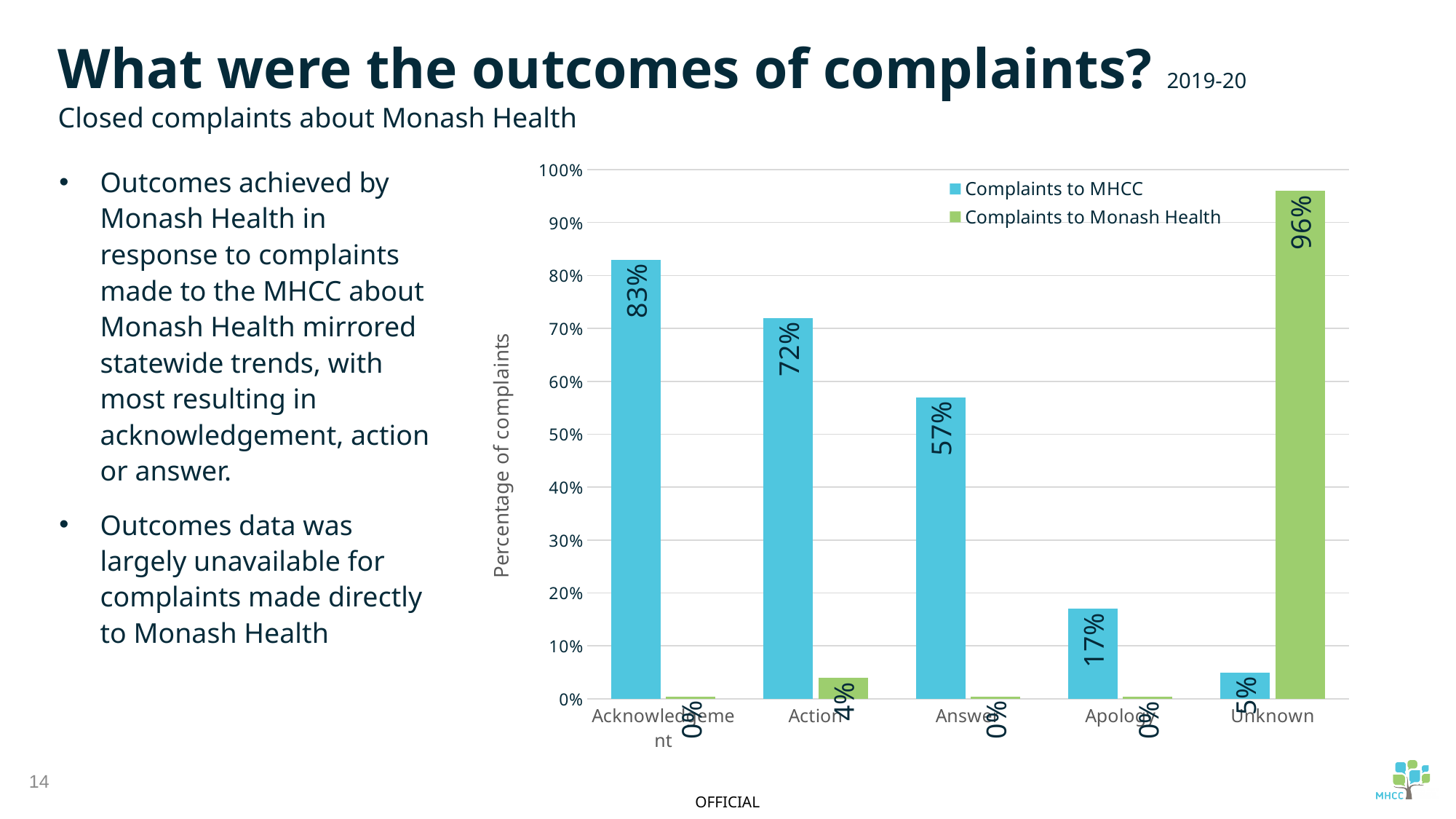
What percentage of complaints to Monash Health have an Unknown outcome? 96% What percentage of complaints to MHCC resulted in Acknowledgement? 83% Which outcome category has the highest value for Complaints to MHCC? Acknowledgement What percentage of complaints to MHCC resulted in an Apology? 17% For the Answer category, which series has the larger value: Complaints to MHCC or Complaints to Monash Health? Complaints to MHCC What is the label of the vertical axis? Percentage of complaints What is the value for Action in the Complaints to Monash Health series? 4% What is the difference between the Complaints to MHCC values for Acknowledgement and Action? 11% How many outcome categories are shown on the x axis? 5 What kind of chart is shown on the slide? Bar chart Which outcome category has the lowest value for Complaints to MHCC? Unknown How many series does the legend list? 2